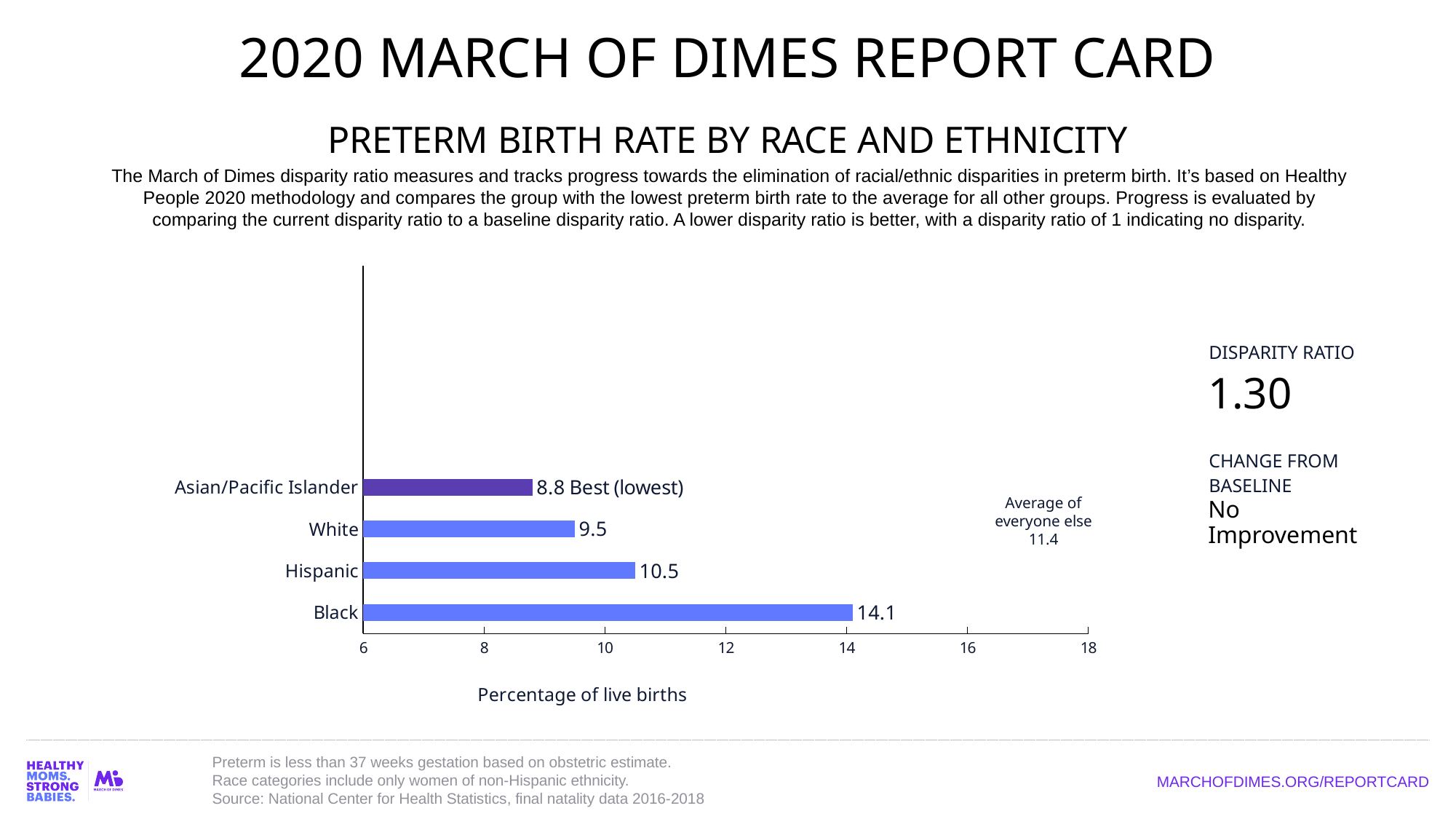
What is the preterm birth rate for Hispanic women shown on the chart? 10.5 What is the preterm birth rate for Asian/Pacific Islander women shown on the chart? 8.8 Which race/ethnicity group has the lowest preterm birth rate on the chart? Asian/Pacific Islander Which race/ethnicity group has the highest preterm birth rate on the chart? Black What is the preterm birth rate for White women shown on the chart? 9.5 Which group has a higher preterm birth rate, Hispanic or White? Hispanic What is the preterm birth rate for Black women shown on the chart? 14.1 What is the difference between the preterm birth rate for Black women and for Asian/Pacific Islander women? 5.3 What is the label of the x axis on the chart? Percentage of live births How many race/ethnicity categories are plotted on the chart? 4 Is the preterm birth rate for Black women greater or less than 12? greater What kind of chart is used to show preterm birth rate by race and ethnicity? Bar chart